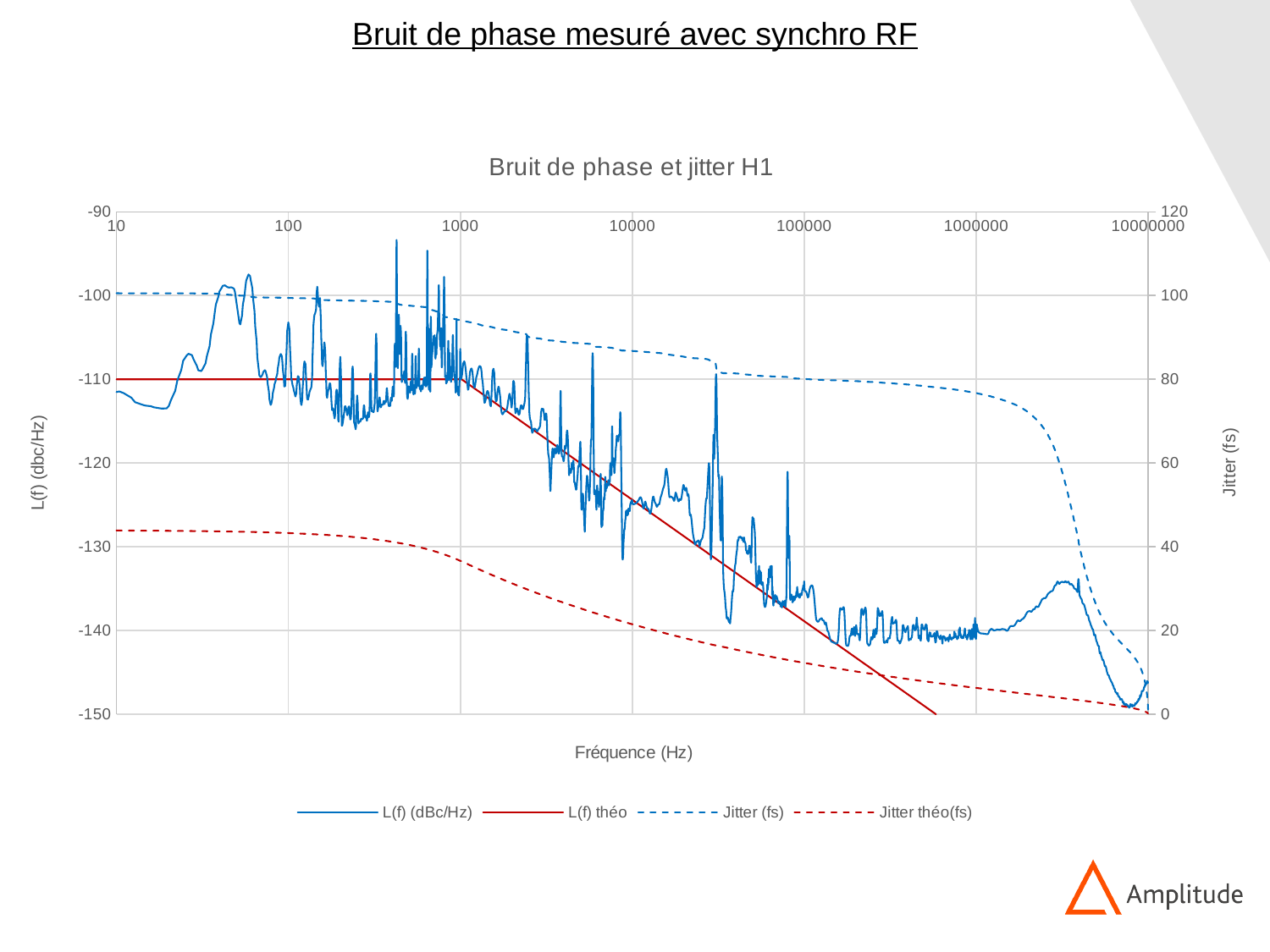
Is the value of L(f) (dBc/Hz) at 100000 Hz greater or less than -130? less Is the value of Jitter théo(fs) at 10 Hz greater or less than 60? less At 10 Hz, which is larger: Jitter (fs) or Jitter théo(fs)? Jitter (fs) Does the Jitter (fs) series rise or fall as frequency increases along the x axis? fall What kind of chart is shown on the slide? line chart Is the value of Jitter (fs) at 10 Hz greater or less than 80? greater What is the label of the x axis? Fréquence (Hz) What is the title of the chart? Bruit de phase et jitter H1 How many series does the legend list? 4 What is the value of L(f) théo at 100 Hz? -110